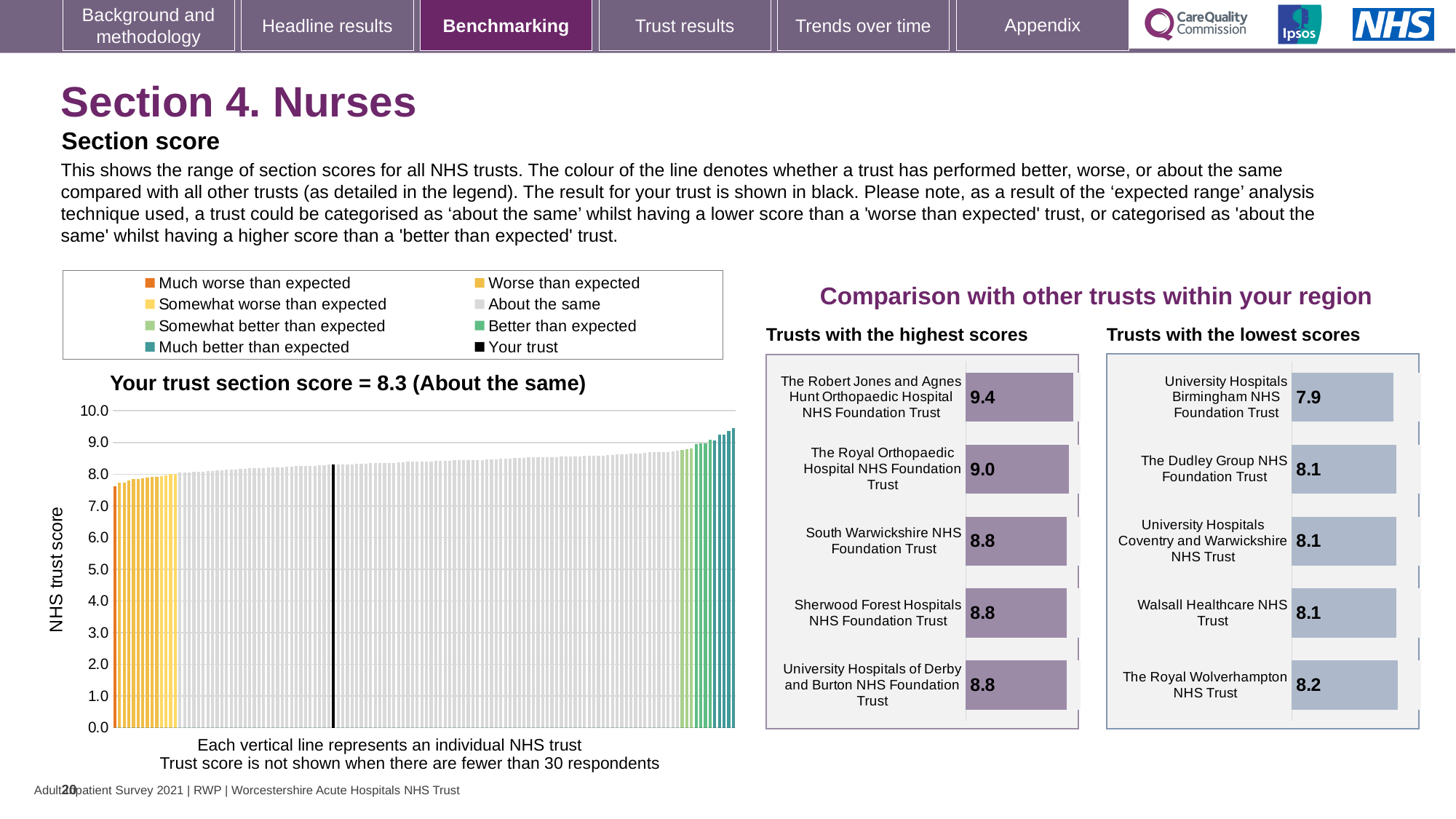
In the 'Trusts with the highest scores' chart, what is the score for The Royal Orthopaedic Hospital NHS Foundation Trust? 9.0 In the 'Trusts with the highest scores' chart, what is the difference between the scores of The Robert Jones and Agnes Hunt Orthopaedic Hospital NHS Foundation Trust and The Royal Orthopaedic Hospital NHS Foundation Trust? 0.4 In the 'Trusts with the lowest scores' chart, which has the higher score: The Dudley Group NHS Foundation Trust or The Royal Wolverhampton NHS Trust? The Royal Wolverhampton NHS Trust What kind of chart is the 'Trusts with the lowest scores' chart? Bar chart In the 'Trusts with the lowest scores' chart, what is the score for Walsall Healthcare NHS Trust? 8.1 How many entries does the legend above the main chart on the left list? 8 In the 'Trusts with the lowest scores' chart, which trust has the lowest score? University Hospitals Birmingham NHS Foundation Trust In the main chart on the left, which category is your trust's section score placed in? About the same How many trusts are shown in the 'Trusts with the highest scores' chart? 5 In the main chart on the left, what is your trust's section score? 8.3 In the 'Trusts with the highest scores' chart, what is the score for The Robert Jones and Agnes Hunt Orthopaedic Hospital NHS Foundation Trust? 9.4 In the 'Trusts with the highest scores' chart, which trust has the highest score? The Robert Jones and Agnes Hunt Orthopaedic Hospital NHS Foundation Trust